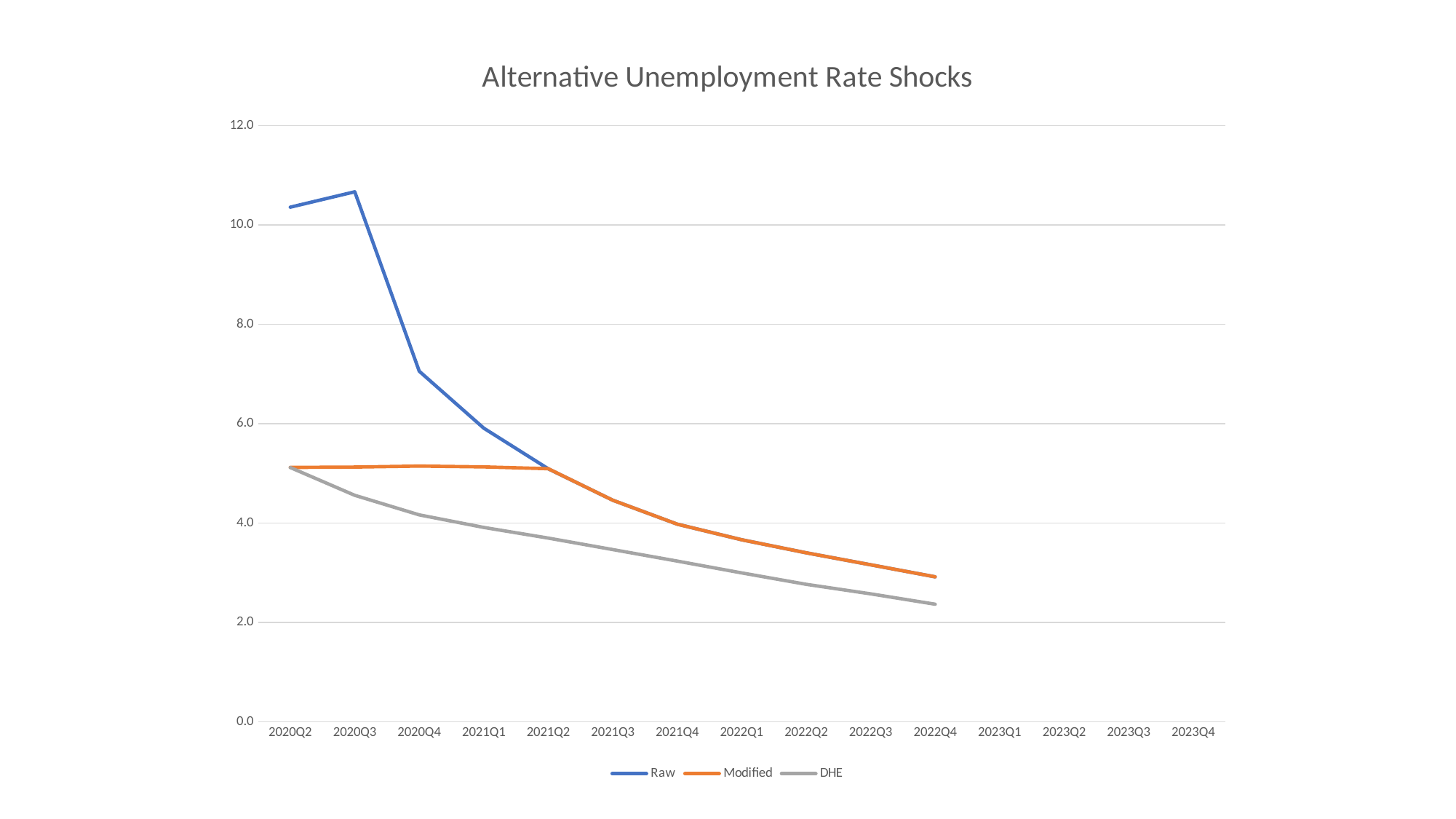
How many quarters are labelled along the x axis? 15 In which quarter does the Raw series reach its highest value? 2020Q3 At 2020Q4, which series has the larger value, Raw or DHE? Raw How many series does the legend list? 3 Does the DHE series rise or fall from 2020Q2 to 2022Q4? fall Is the value of the Modified series at 2022Q2 greater or less than 4.0? less What is the title of the chart? Alternative Unemployment Rate Shocks Is the value of the Raw series at 2020Q2 greater or less than 10.0? greater At 2022Q4, which series has the larger value, Modified or DHE? Modified Is the value of the DHE series at 2022Q4 greater or less than 2.0? greater What kind of chart is shown on the slide? line chart